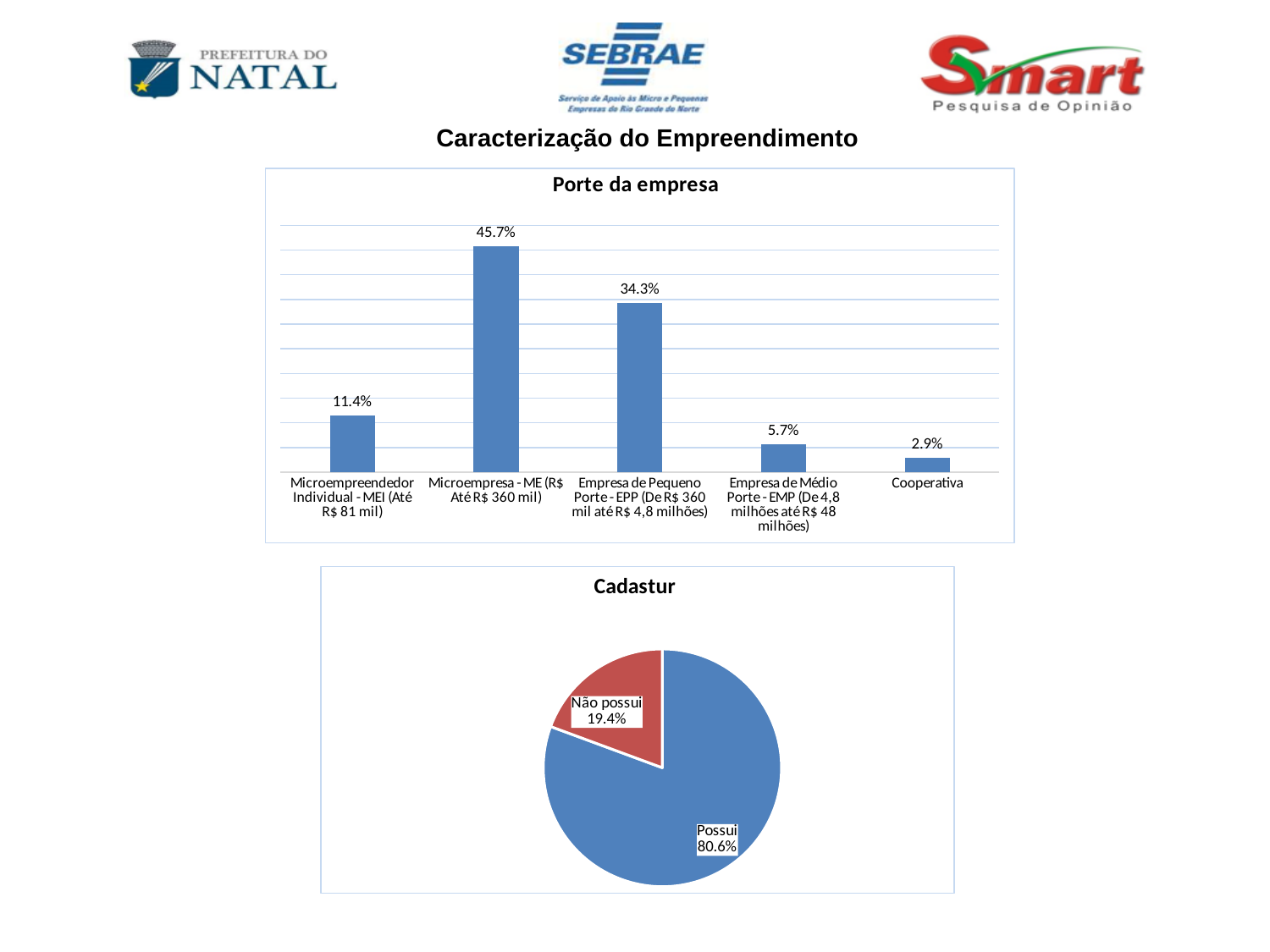
In the 'Cadastur' chart, what is the value for 'Não possui'? 19.4% In the 'Porte da empresa' chart, what is the value for Cooperativa? 2.9% In the 'Cadastur' chart, what share of the pie is 'Possui'? 80.6% In the 'Porte da empresa' chart, what is the value for Microempresa - ME? 45.7% How many categories are shown in the 'Porte da empresa' chart? 5 In the 'Porte da empresa' chart, what is the difference between Microempresa - ME and Empresa de Pequeno Porte - EPP? 11.4% In the 'Porte da empresa' chart, which category has the highest value? Microempresa - ME What kind of chart is 'Porte da empresa'? Bar chart In the 'Porte da empresa' chart, what is the value for Empresa de Médio Porte - EMP? 5.7% What kind of chart is 'Cadastur'? Pie chart In the 'Porte da empresa' chart, which category has the lowest value? Cooperativa In the 'Porte da empresa' chart, which is larger: Microempreendedor Individual - MEI or Empresa de Médio Porte - EMP? Microempreendedor Individual - MEI